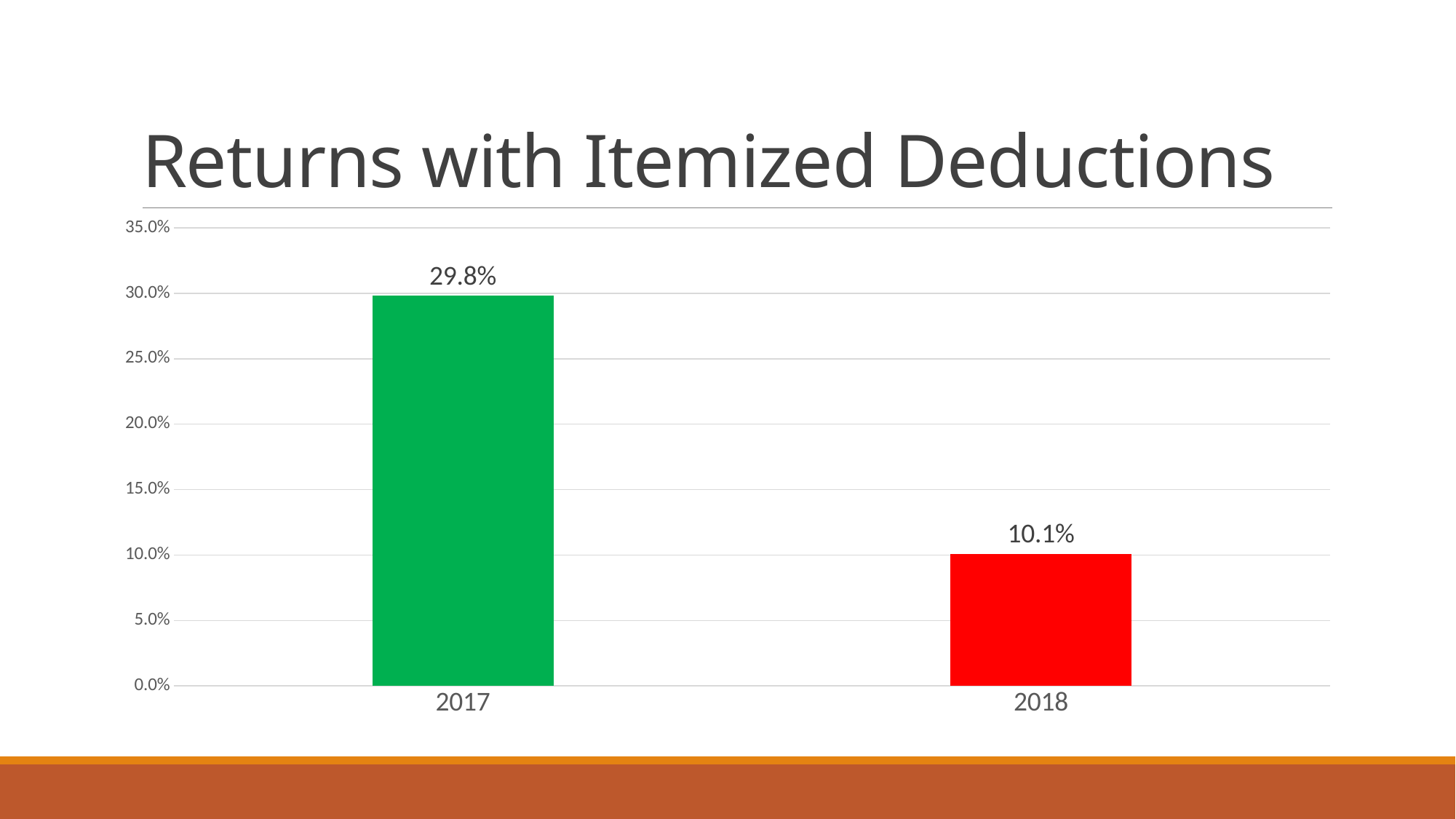
Is the value for 2018 greater or less than 15.0%? less Is the value for 2017 greater or less than 25.0%? greater Do the values rise or fall from 2017 to 2018? fall What is the value for 2018? 10.1% How many categories are shown on the x axis? 2 What kind of chart is shown on the slide? bar chart Which is larger, the value for 2017 or the value for 2018? 2017 What is the title of the chart? Returns with Itemized Deductions What is the value for 2017? 29.8% Which year has the highest value? 2017 What is the difference between the 2017 and 2018 values? 19.7% Which year has the lowest value? 2018